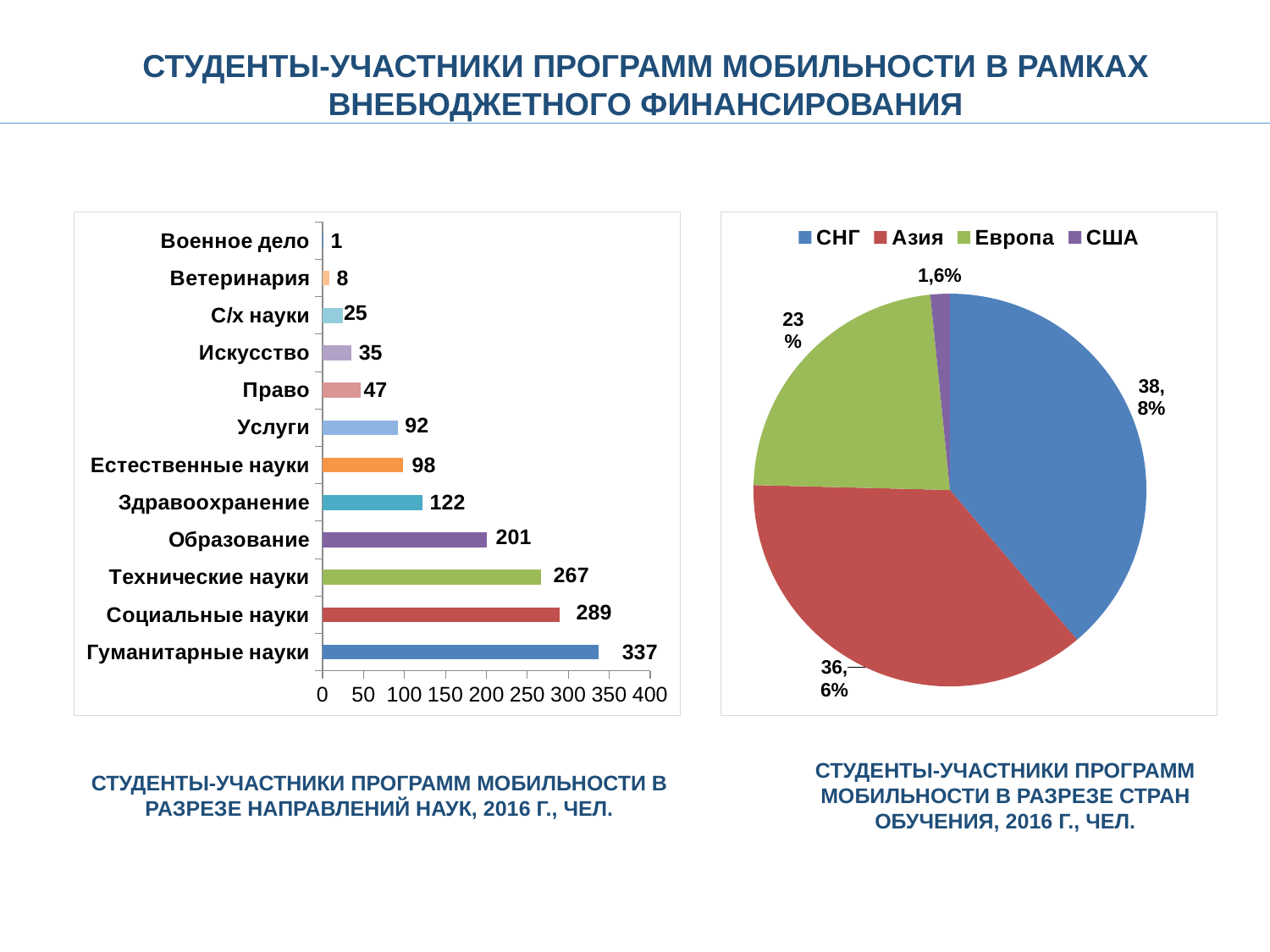
On the left bar chart, which category has the highest value? Гуманитарные науки On the left bar chart, which category has the lowest value? Военное дело How many categories does the left bar chart show? 12 On the right pie chart, what share does США have? 1,6% How many entries does the legend of the right pie chart list? 4 On the left bar chart, what is the difference between Социальные науки and Технические науки? 22 On the left bar chart, what is the value for Здравоохранение? 122 On the left bar chart, which is larger: Услуги or Естественные науки? Естественные науки On the right pie chart, what share does Азия have? 36,6% What kind of chart is the chart on the left? bar chart On the right pie chart, which slice is the largest? СНГ On the left bar chart, what is the value for Гуманитарные науки? 337